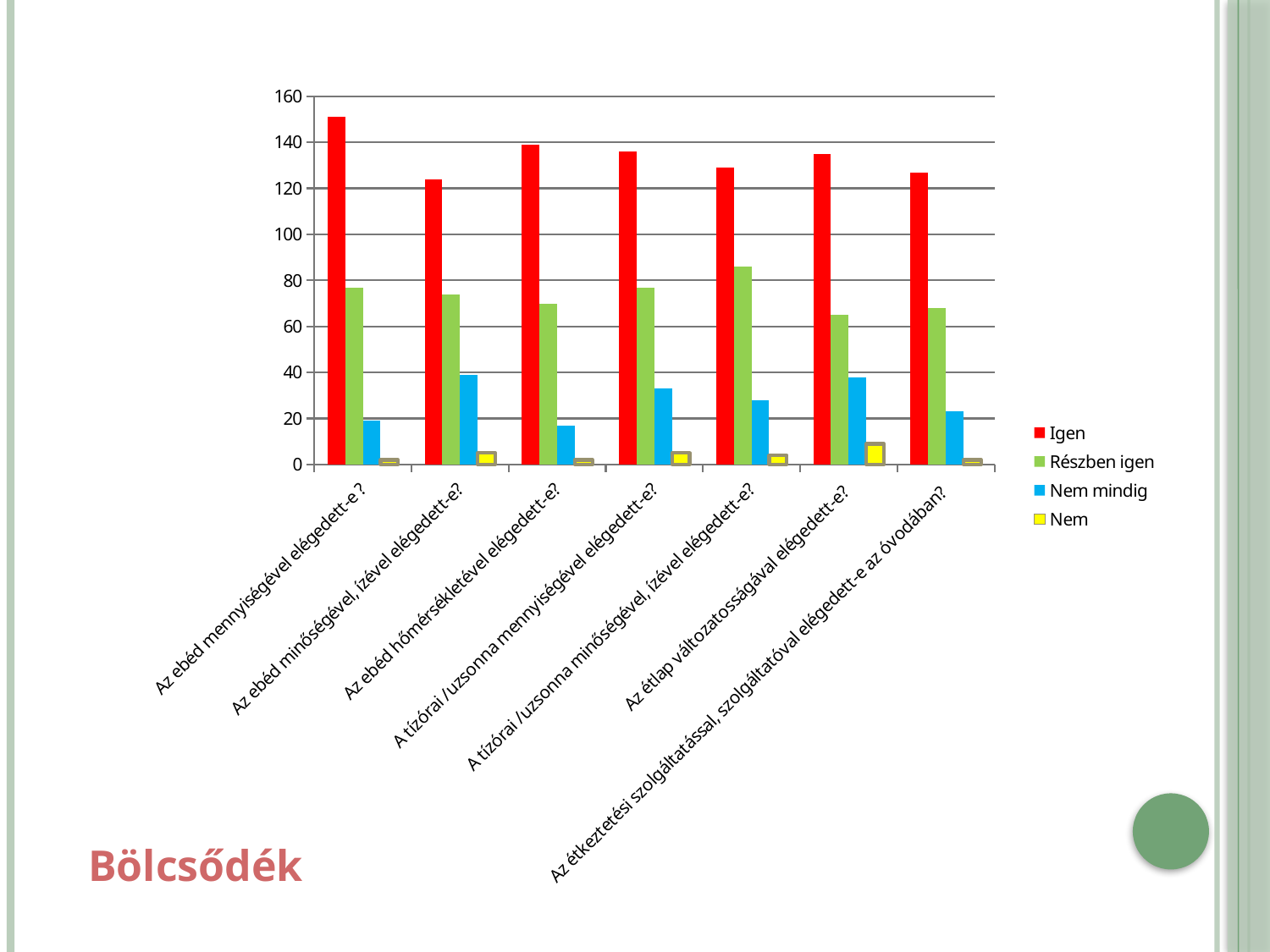
Is the 'Igen' value for 'Az ebéd mennyiségével elégedett-e ?' greater or less than 140? greater What kind of chart is shown on the slide? bar chart For which category is the 'Részben igen' value highest? A tízórai /uzsonna minőségével, ízével elégedett-e? Is the 'Részben igen' value for 'A tízórai /uzsonna minőségével, ízével elégedett-e?' greater or less than 80? greater Which colour represents the 'Nem mindig' series in the legend? blue Which is larger for 'Az ebéd hőmérsékletével elégedett-e?': the 'Igen' value or the 'Részben igen' value? Igen Is the 'Igen' value for 'Az ebéd minőségével, ízével elégedett-e?' greater or less than 140? less For which category is the 'Igen' value highest? Az ebéd mennyiségével elégedett-e ? How many question categories are shown along the x axis? 7 How many series does the legend list? 4 For which category is the 'Nem' value highest? Az étlap változatosságával elégedett-e?